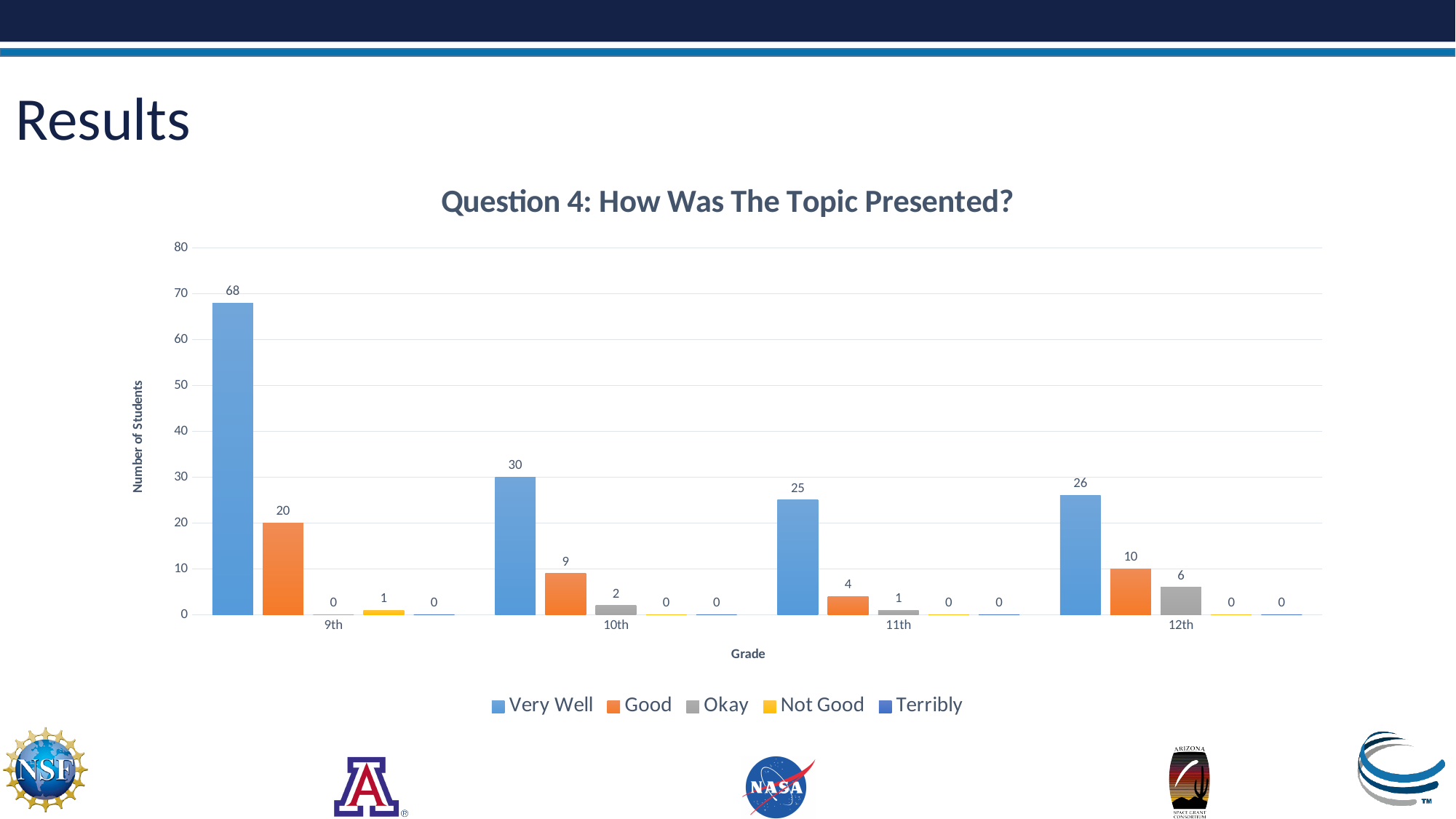
What is the difference between the Very Well values for 9th and 10th grade? 38 How many grade categories are shown on the x axis? 4 Which is larger, the Very Well value for 11th grade or for 12th grade? 12th Which grade has the highest Very Well value? 9th Which grade has the lowest Good value? 11th How many series does the legend list? 5 What is the value for Good in 12th grade? 10 What kind of chart is shown? bar chart What is the value for Very Well in 9th grade? 68 Is the value for Very Well in 9th grade greater or less than 60? greater What is the value for Okay in 11th grade? 1 What is the title of the chart? Question 4: How Was The Topic Presented?